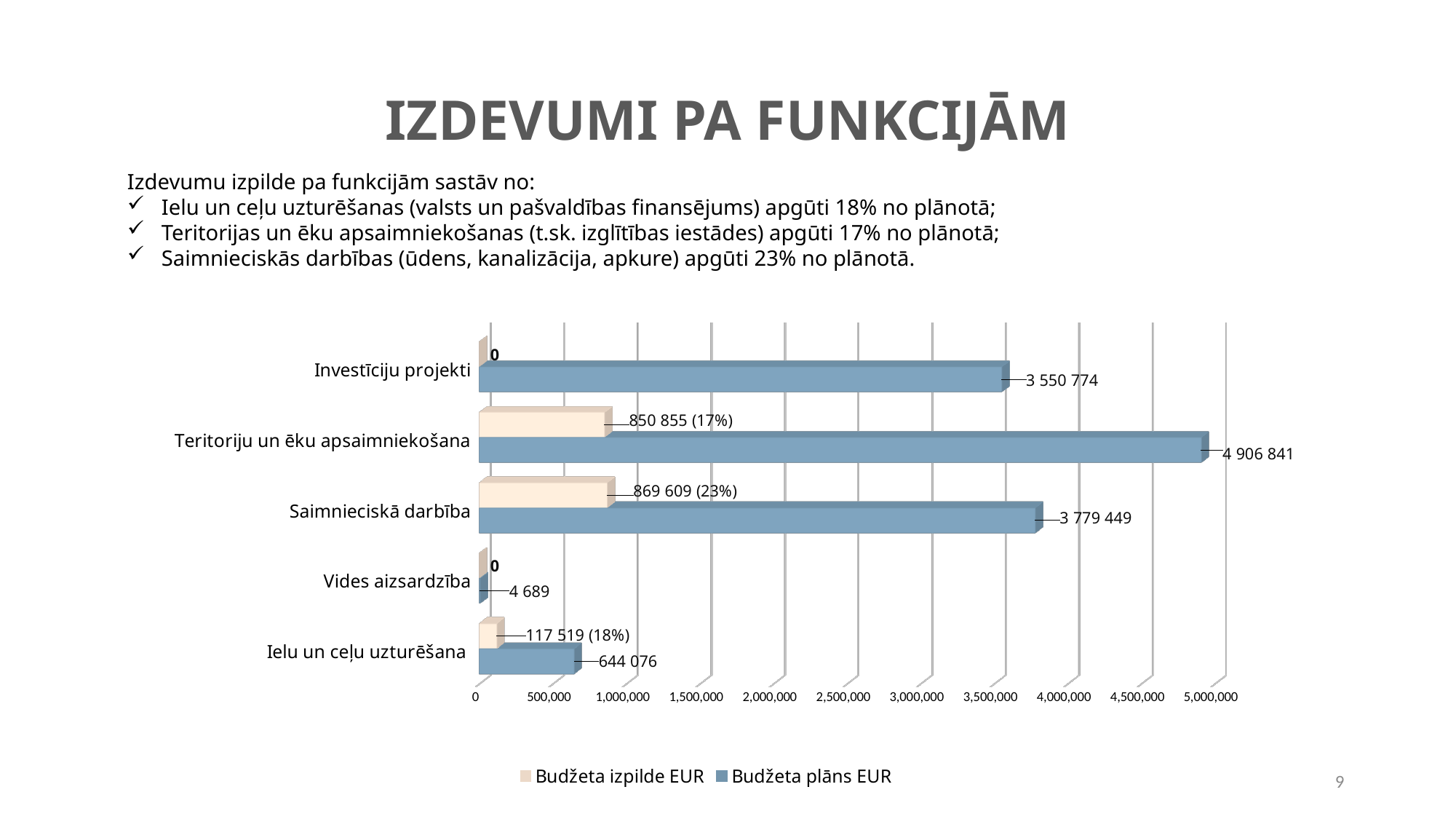
What is the Budžeta plāns EUR value for Vides aizsardzība? 4 689 What is the Budžeta izpilde EUR value for Saimnieciskā darbība? 869 609 How many categories are shown on the chart? 5 Is the Budžeta plāns EUR value for Ielu un ceļu uzturēšana greater or less than 1,000,000? less What is the difference between the Budžeta plāns EUR values for Teritoriju un ēku apsaimniekošana and Saimnieciskā darbība? 1 127 392 How many series does the legend list? 2 What is the Budžeta izpilde EUR value for Ielu un ceļu uzturēšana? 117 519 Which category has the lowest Budžeta plāns EUR value? Vides aizsardzība Which category has the highest Budžeta plāns EUR value? Teritoriju un ēku apsaimniekošana What is the Budžeta plāns EUR value for Teritoriju un ēku apsaimniekošana? 4 906 841 What kind of chart is shown on the slide? bar chart Which is larger: the Budžeta plāns EUR value for Investīciju projekti or for Saimnieciskā darbība? Saimnieciskā darbība